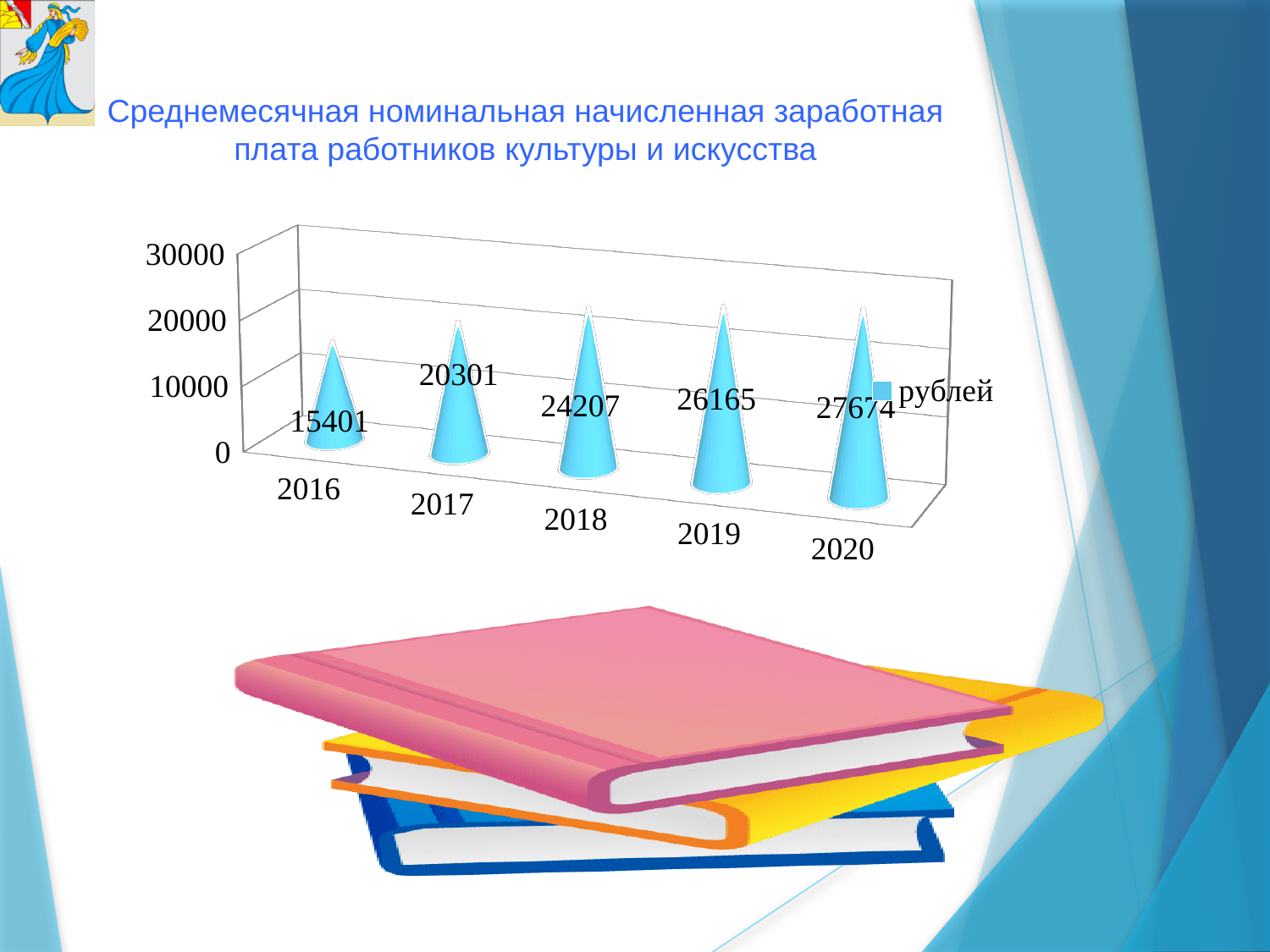
What is the difference between the values for 2019 and 2018? 1958 What is the difference between the values for 2020 and 2016? 12273 What is the legend entry shown on the chart? рублей What is the value for 2020? 27674 How many years are shown on the x axis? 5 What is the value for 2016? 15401 Which year has the lowest value? 2016 What is the value for 2018? 24207 Is the value for 2016 greater or less than 20000? less Which is larger, the value for 2017 or the value for 2019? 2019 Do the values rise or fall from 2016 to 2020? rise Which year has the highest value? 2020